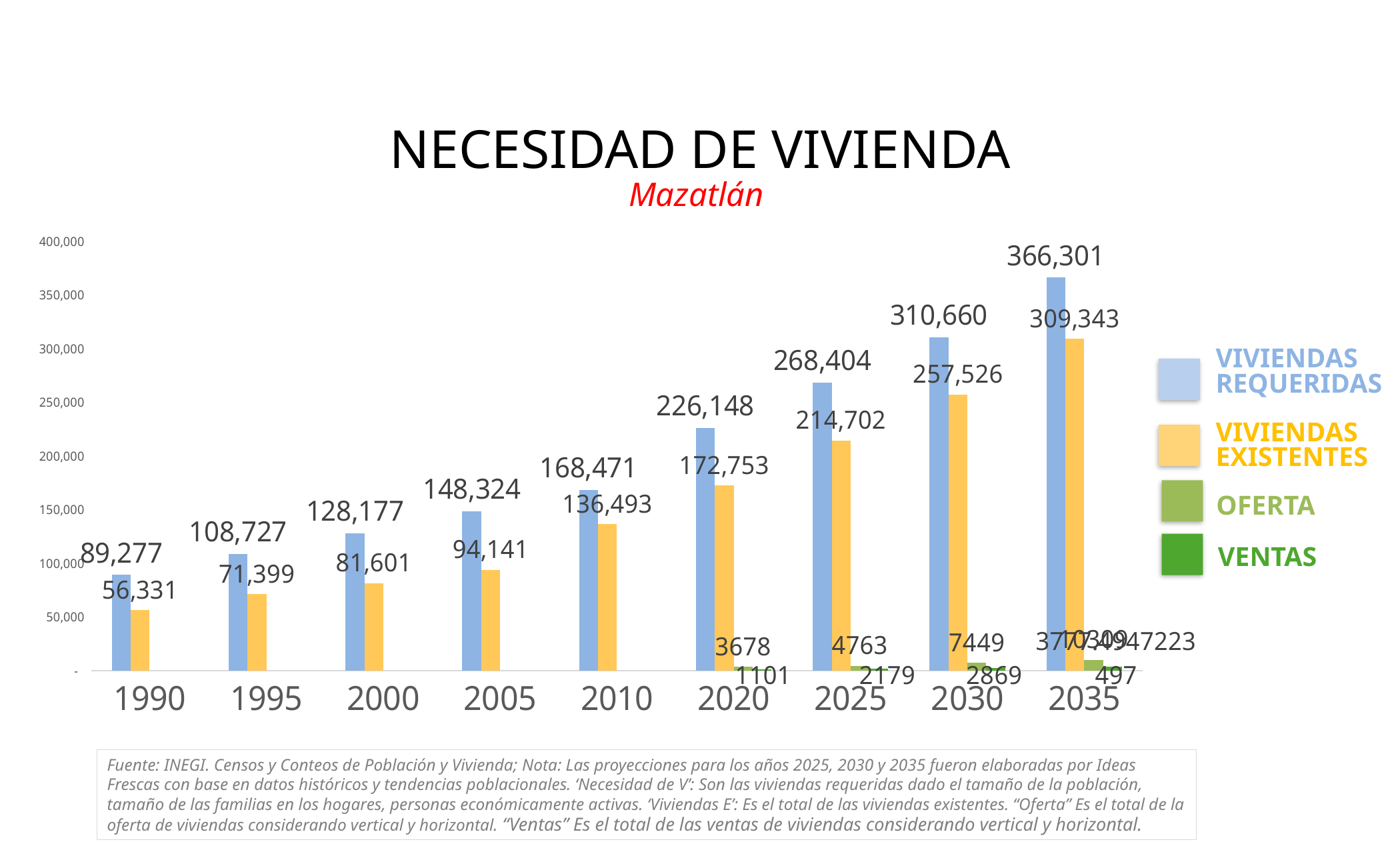
How many years are shown on the x axis? 9 What is the value of VIVIENDAS EXISTENTES for 2010? 136,493 In which year is VIVIENDAS EXISTENTES lowest? 1990 What is the value of VIVIENDAS REQUERIDAS for 2035? 366,301 What is the OFERTA value for 2030? 7449 How many series does the legend list? 4 In which year is VIVIENDAS REQUERIDAS highest? 2035 Do the VIVIENDAS REQUERIDAS values rise or fall from 1990 to 2035? rise Which is larger: VIVIENDAS REQUERIDAS in 2020 or VIVIENDAS EXISTENTES in 2025? VIVIENDAS REQUERIDAS in 2020 What is the difference between VIVIENDAS REQUERIDAS and VIVIENDAS EXISTENTES in 2030? 53,134 What is the VENTAS value for 2025? 2179 What is the difference between VIVIENDAS REQUERIDAS and VIVIENDAS EXISTENTES in 1990? 32,946